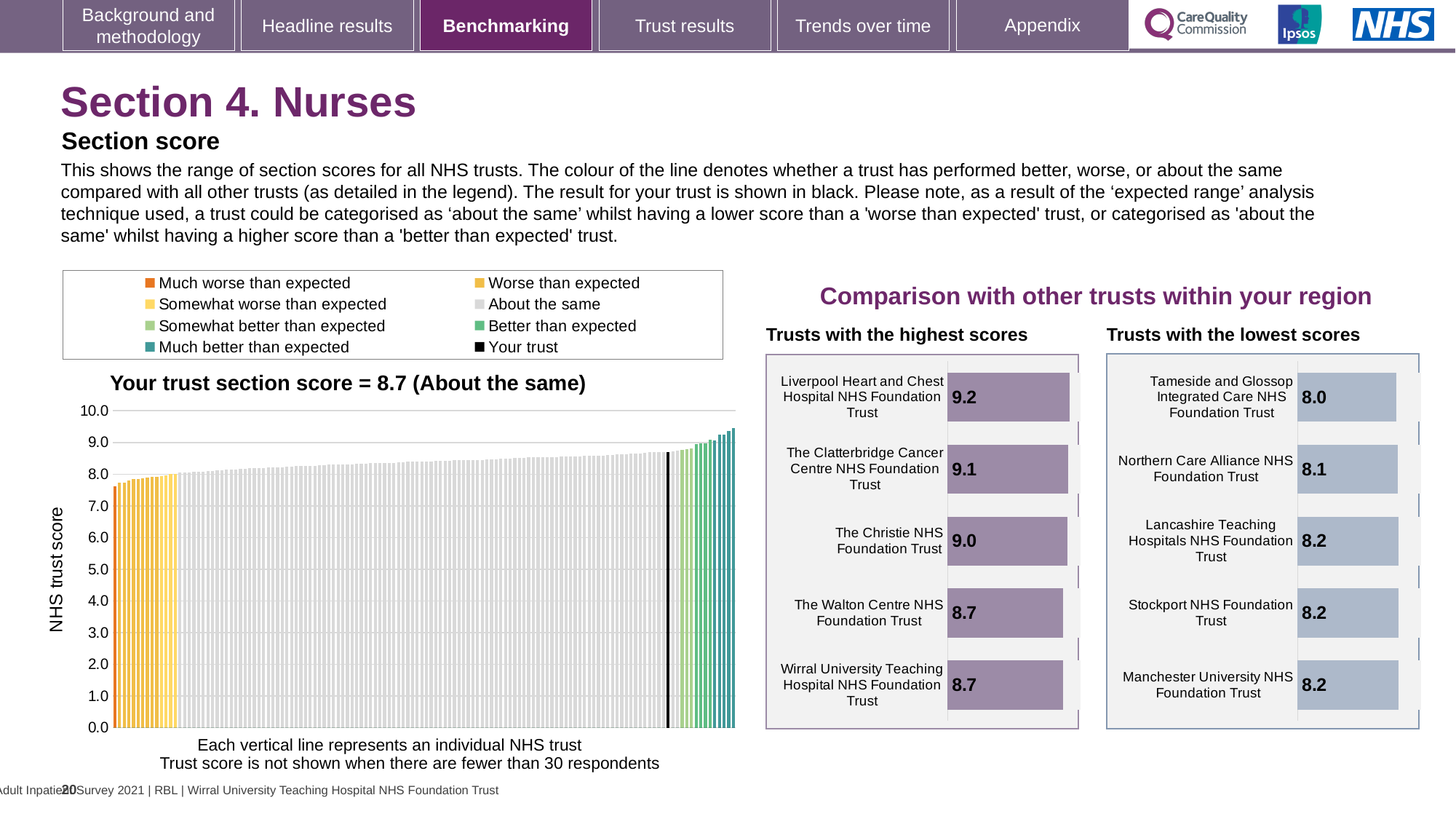
What kind of chart is the main chart on the left showing NHS trust scores? Bar chart In the 'Trusts with the highest scores' chart, which trust has the highest score? Liverpool Heart and Chest Hospital NHS Foundation Trust In the 'Trusts with the highest scores' chart, which has the larger score: The Clatterbridge Cancer Centre NHS Foundation Trust or Wirral University Teaching Hospital NHS Foundation Trust? The Clatterbridge Cancer Centre NHS Foundation Trust In the 'Trusts with the lowest scores' chart, which trust has the lowest score? Tameside and Glossop Integrated Care NHS Foundation Trust In the 'Trusts with the lowest scores' chart, what is the score for Northern Care Alliance NHS Foundation Trust? 8.1 In the 'Trusts with the lowest scores' chart, what is the difference between the scores of Stockport NHS Foundation Trust and Tameside and Glossop Integrated Care NHS Foundation Trust? 0.2 In the 'Trusts with the highest scores' chart, what is the score for Liverpool Heart and Chest Hospital NHS Foundation Trust? 9.2 In the 'Trusts with the highest scores' chart, what is the score for The Christie NHS Foundation Trust? 9.0 How many entries does the legend above the main chart on the left list? 8 How many trusts are shown in the 'Trusts with the lowest scores' chart? 5 In the 'Trusts with the highest scores' chart, what is the difference between the scores of Liverpool Heart and Chest Hospital NHS Foundation Trust and The Walton Centre NHS Foundation Trust? 0.5 What is the section score for your trust shown in the main chart on the left? 8.7